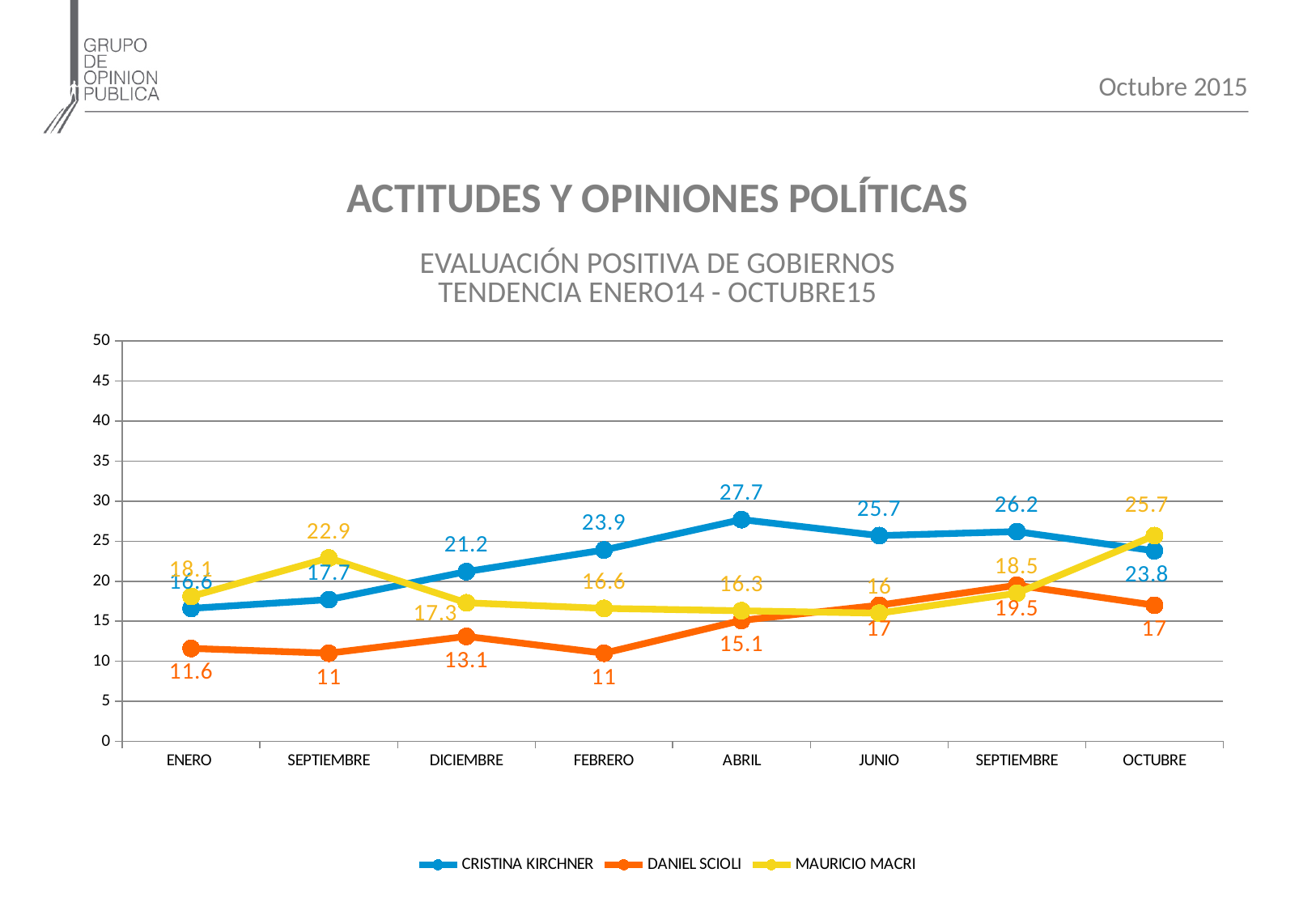
How many points along the x axis does each line have? 8 What is the value for Cristina Kirchner in ABRIL? 27.7 Does Cristina Kirchner's line rise or fall from ENERO to ABRIL? rise In OCTUBRE, who has the higher value, Mauricio Macri or Cristina Kirchner? Mauricio Macri How many series does the legend list? 3 What kind of chart is shown on the slide? Line chart In which month is Cristina Kirchner's value lowest? ENERO What is the value for Daniel Scioli in ENERO? 11.6 In which month does Cristina Kirchner reach her highest value? ABRIL What is the difference between Cristina Kirchner's and Daniel Scioli's values in ABRIL? 12.6 What is the value for Mauricio Macri in OCTUBRE? 25.7 Is the value for Daniel Scioli in FEBRERO greater or less than 15? less